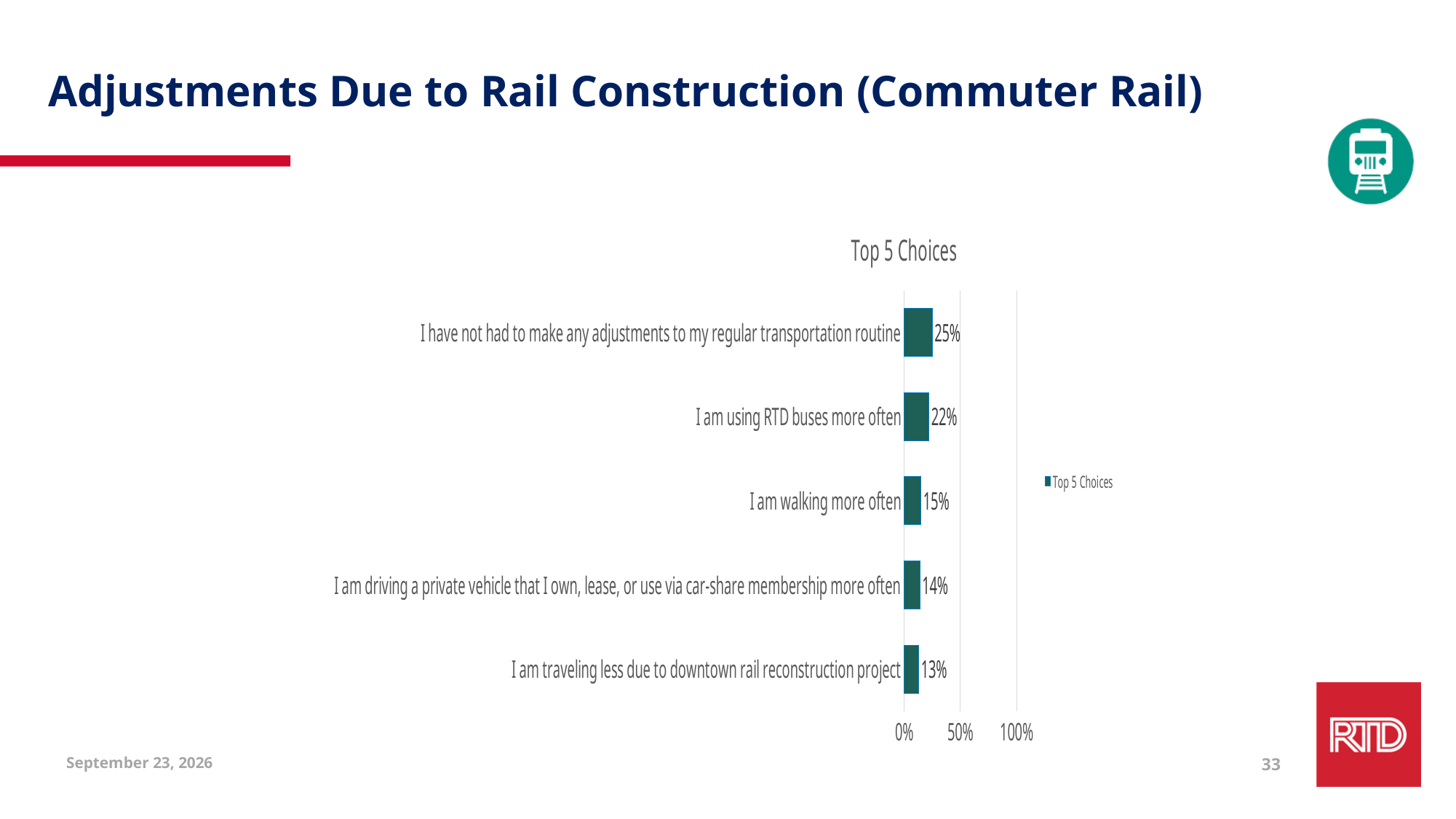
What is the title of the chart? Top 5 Choices What is the value for "I am walking more often"? 15% What is the difference between the value for "I am using RTD buses more often" and the value for "I am walking more often"? 7% Which category has the highest value in the chart? I have not had to make any adjustments to my regular transportation routine What kind of chart is shown on the slide? bar chart What percentage of respondents said they have not had to make any adjustments to their regular transportation routine? 25% Which is larger: the value for "I am driving a private vehicle that I own, lease, or use via car-share membership more often" or the value for "I am using RTD buses more often"? I am using RTD buses more often What is the value for "I am traveling less due to downtown rail reconstruction project"? 13% What is the value for "I am using RTD buses more often"? 22% How many categories are shown in the chart? 5 Is the value for "I have not had to make any adjustments to my regular transportation routine" greater or less than 50%? less Which category has the lowest value in the chart? I am traveling less due to downtown rail reconstruction project